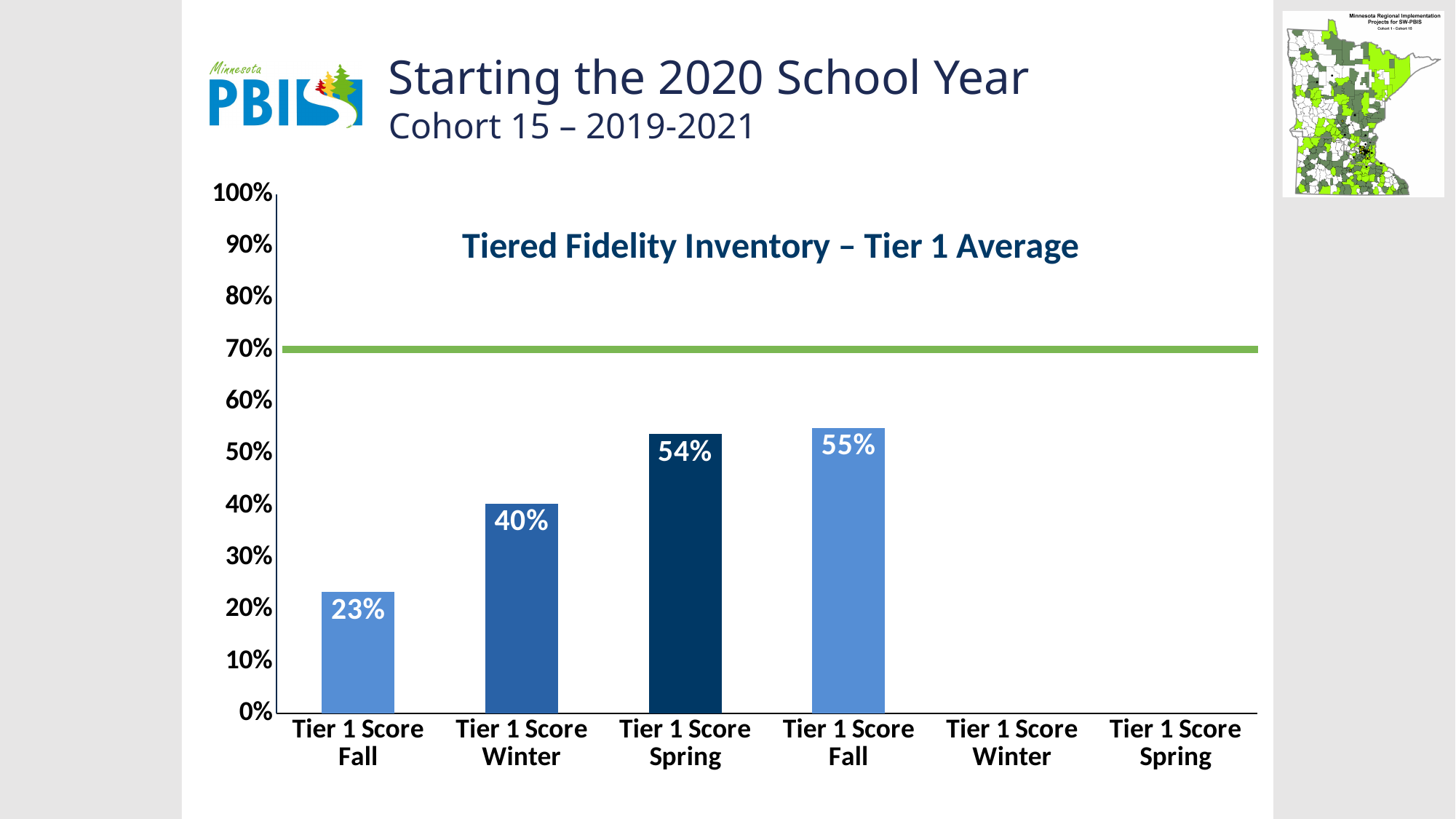
What is the value of the first Tier 1 Score Fall bar? 23% Which is larger, the first Tier 1 Score Winter bar or the first Tier 1 Score Spring bar? Tier 1 Score Spring What is the value of the first Tier 1 Score Winter bar? 40% What kind of chart is shown on the slide? Bar chart How many bars have plotted values on the chart? 4 What is the value of the second Tier 1 Score Fall bar (the fourth bar from the left)? 55% Is the value of the first Tier 1 Score Spring bar greater or less than 70%? less What is the title of the chart? Tiered Fidelity Inventory – Tier 1 Average What is the value of the first Tier 1 Score Spring bar? 54% What is the difference between the first Tier 1 Score Winter bar and the first Tier 1 Score Fall bar? 17% Which bar has the lowest value? The first Tier 1 Score Fall bar (23%) Which bar has the highest value? The second Tier 1 Score Fall bar (55%)